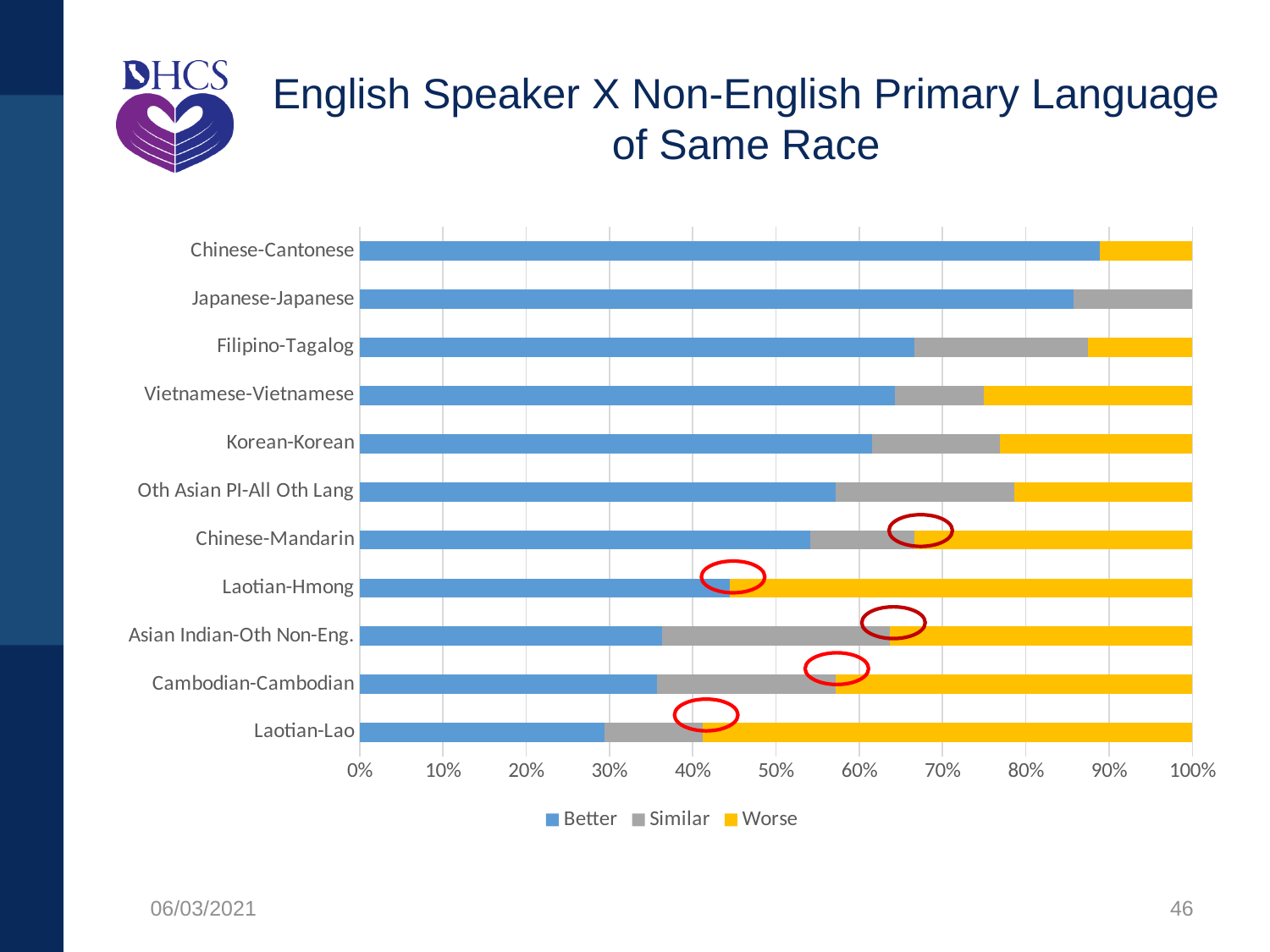
Which category has the smallest 'Better' share? Laotian-Lao How many language groups (categories) are plotted on the chart? 11 Is the 'Better' share for Laotian-Lao greater or less than 40%? less Is the 'Better' share for Filipino-Tagalog greater or less than 60%? greater Which colour represents the 'Worse' series in the legend? Yellow Which has a larger 'Worse' share, Laotian-Lao or Chinese-Cantonese? Laotian-Lao How many series does the legend list? 3 What does each stacked bar total? 100% Is the 'Better' share for Chinese-Cantonese greater or less than 80%? greater Which category has the largest 'Better' share? Chinese-Cantonese What kind of chart is shown on the slide? Stacked bar chart Which has a larger 'Better' share, Chinese-Mandarin or Laotian-Hmong? Chinese-Mandarin